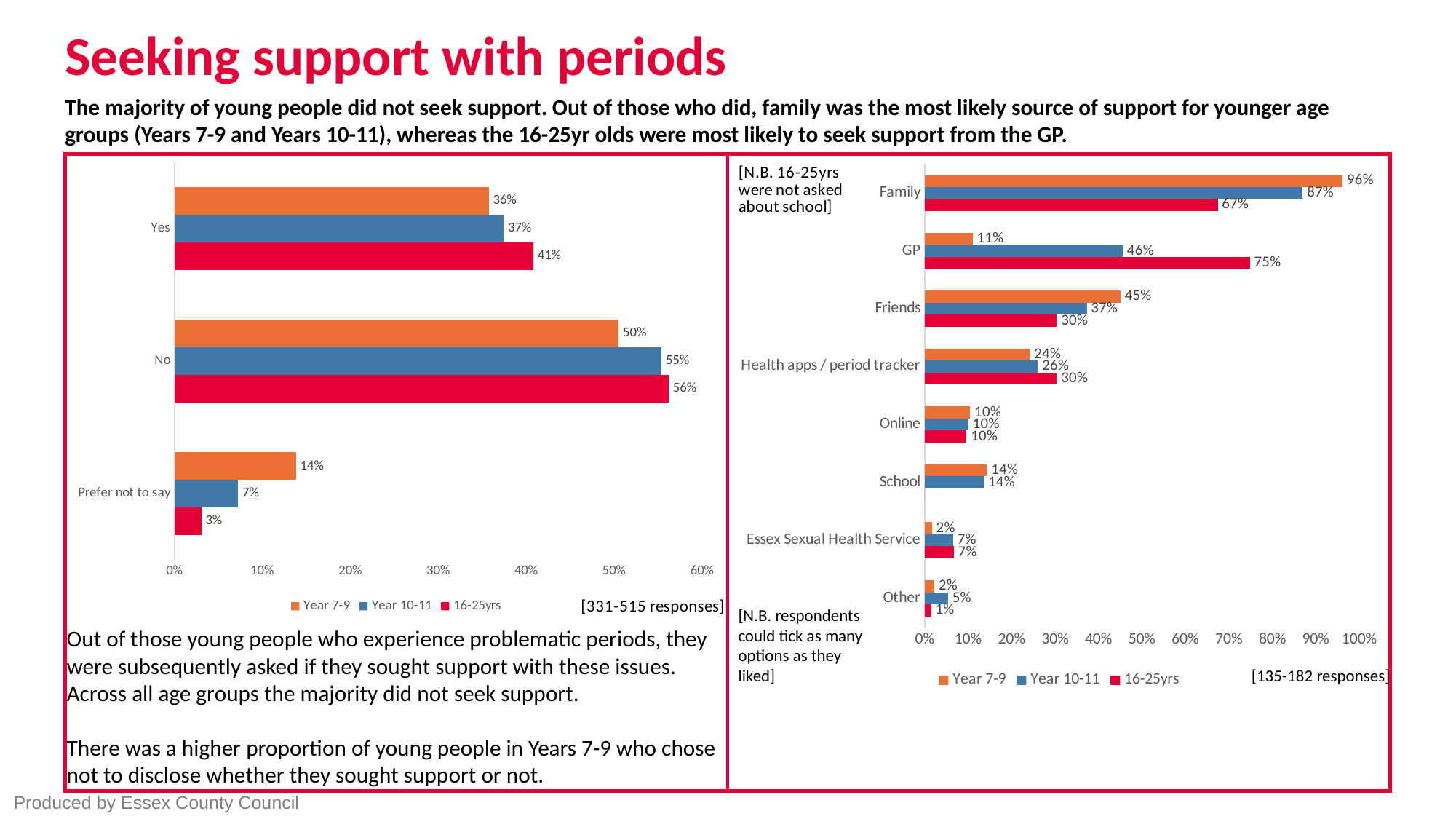
In the right chart, what is the value for Year 7-9 for Family? 96% In the left chart, what is the difference between the Year 7-9 and 16-25yrs values for 'Prefer not to say'? 11% In the left chart, which age group has the highest value for 'Prefer not to say'? Year 7-9 In the right chart, what is the difference between the Year 10-11 and Year 7-9 values for GP? 35% What type of chart is the left chart? Bar chart In the left chart, what is the value for 16-25yrs in the 'Yes' category? 41% In the right chart, how many sources of support are listed on the category axis? 8 In the left chart, how many series does the legend list? 3 In the right chart, which source of support has the lowest value for 16-25yrs? Other In the right chart, what is the value for 16-25yrs for GP? 75% In the right chart, which is larger for Friends: the Year 7-9 value or the 16-25yrs value? Year 7-9 In the left chart, what is the value for Year 10-11 in the 'No' category? 55%